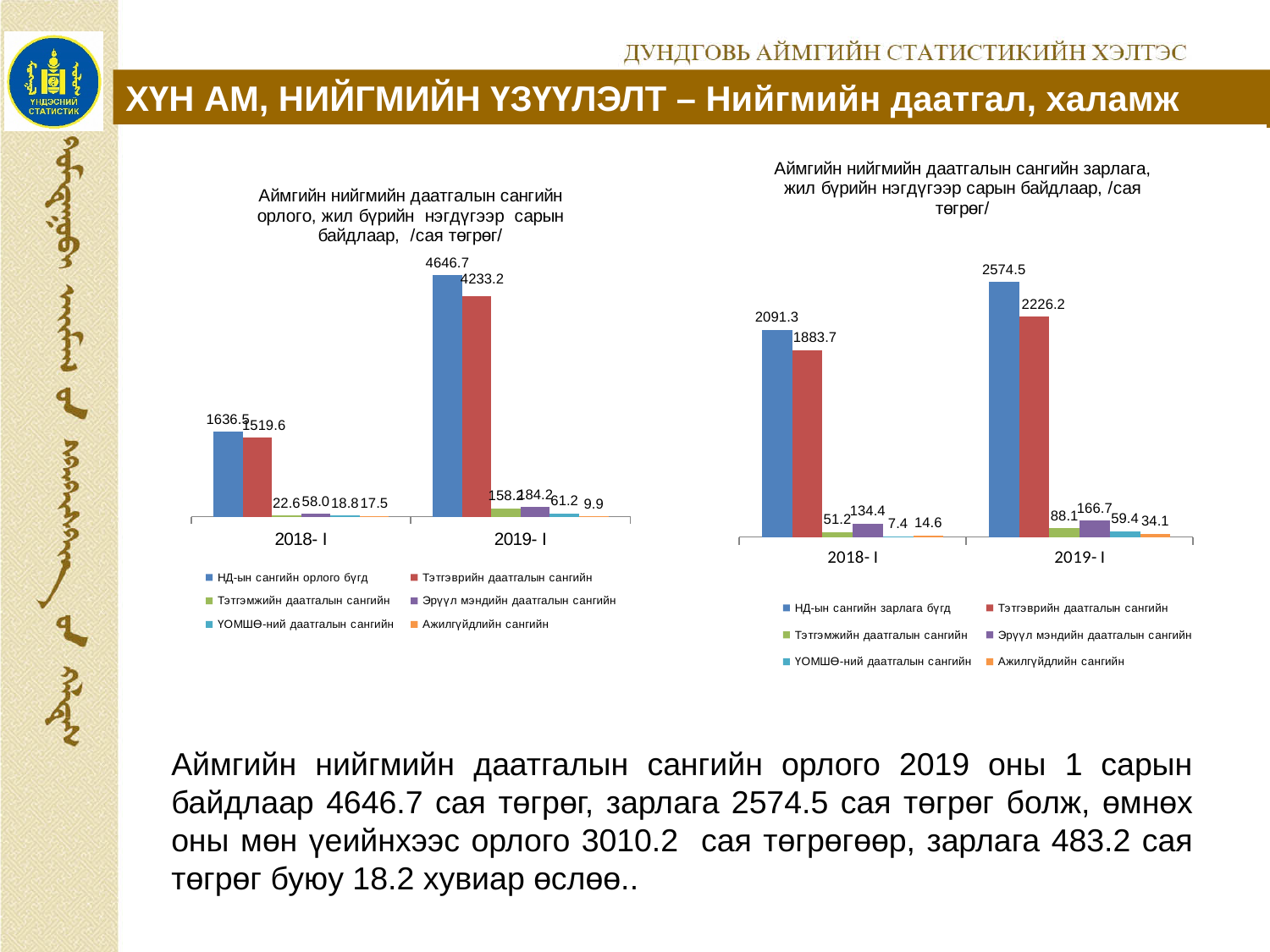
In the left chart (Аймгийн нийгмийн даатгалын сангийн орлого), what is the value of НД-ын сангийн орлого бүгд for 2019-I? 4646.7 In the right chart (Аймгийн нийгмийн даатгалын сангийн зарлага), what is the difference between НД-ын сангийн зарлага бүгд in 2019-I and in 2018-I? 483.2 In the right chart (Аймгийн нийгмийн даатгалын сангийн зарлага), what is the value of НД-ын сангийн зарлага бүгд for 2019-I? 2574.5 In the left chart (Аймгийн нийгмийн даатгалын сангийн орлого), what is the difference between НД-ын сангийн орлого бүгд in 2019-I and in 2018-I? 3010.2 In the right chart (Аймгийн нийгмийн даатгалын сангийн зарлага), what is the value of Эрүүл мэндийн даатгалын сангийн for 2018-I? 134.4 In the left chart (Аймгийн нийгмийн даатгалын сангийн орлого), which series has the highest value for 2019-I? НД-ын сангийн орлого бүгд In the right chart (Аймгийн нийгмийн даатгалын сангийн зарлага), which is larger for 2019-I: Тэтгэмжийн даатгалын сангийн or Эрүүл мэндийн даатгалын сангийн? Эрүүл мэндийн даатгалын сангийн How many series does the legend of the right chart (Аймгийн нийгмийн даатгалын сангийн зарлага) list? 6 In the left chart (Аймгийн нийгмийн даатгалын сангийн орлого), what is the value of Тэтгэврийн даатгалын сангийн for 2018-I? 1519.6 What kind of chart is the right chart (Аймгийн нийгмийн даатгалын сангийн зарлага)? Bar chart In the right chart (Аймгийн нийгмийн даатгалын сангийн зарлага), which series has the lowest value for 2018-I? ҮОМШӨ-ний даатгалын сангийн How many categories are shown on the x axis of the left chart (Аймгийн нийгмийн даатгалын сангийн орлого)? 2